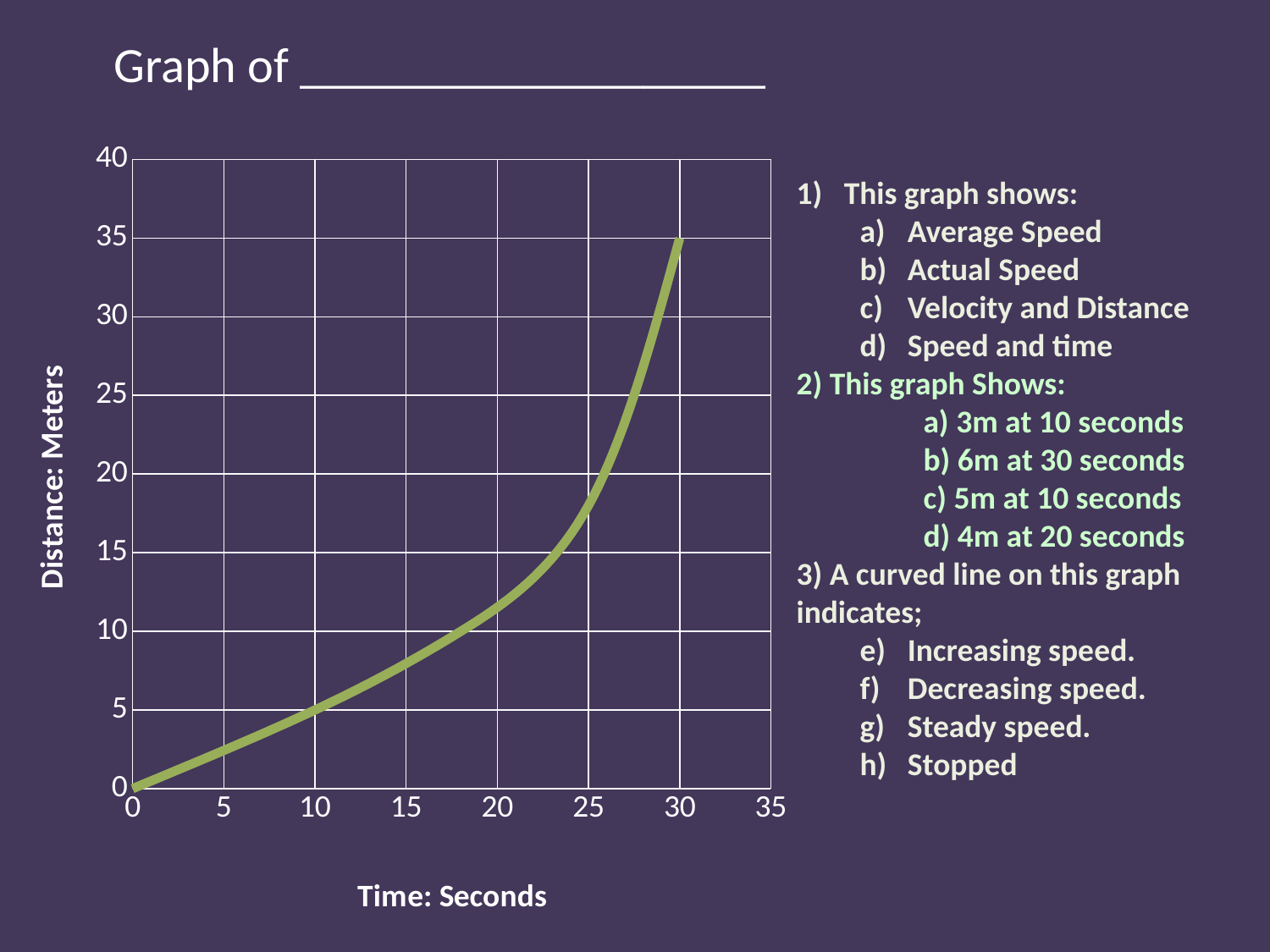
Is the distance at 5 seconds greater or less than 5 meters? less Is the distance at 25 seconds greater or less than 15 meters? greater What is the label of the x axis? Time: Seconds Is the distance at 30 seconds greater or less than 30 meters? greater At which time shown on the x axis is the distance lowest? 0 seconds Which is larger, the distance at 25 seconds or the distance at 15 seconds? 25 seconds Does the distance rise or fall as time increases along the x axis? rises What kind of chart is shown on the slide? line chart What is the label of the y axis? Distance: Meters At which time shown on the x axis does the line reach its highest distance? 30 seconds